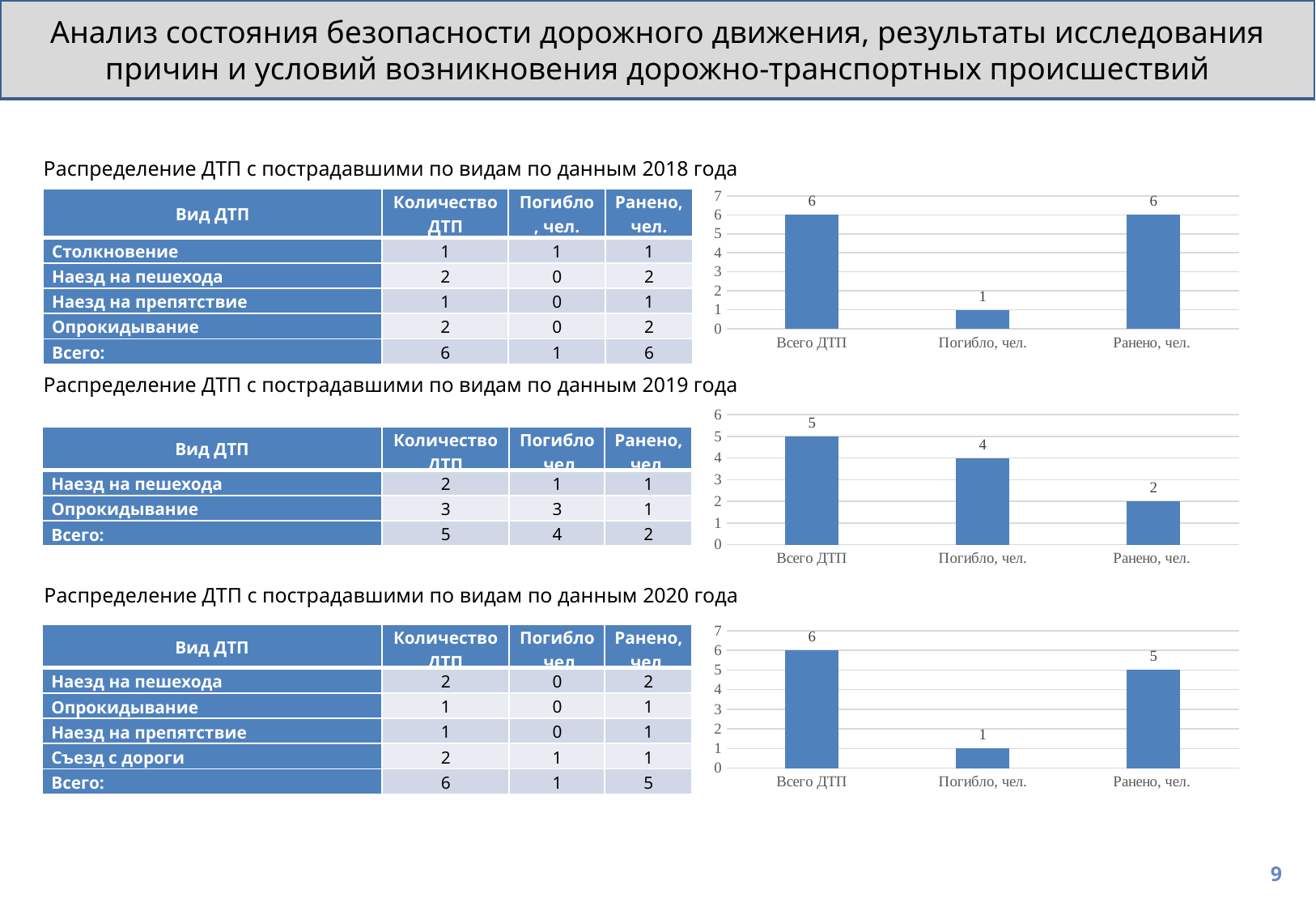
In the top chart (2018 data), what is the value for Всего ДТП? 6 In the bottom chart (2020 data), which category has the highest value? Всего ДТП In the top chart (2018 data), what is the value for Погибло, чел.? 1 In the middle chart (2019 data), what is the difference between Всего ДТП and Ранено, чел.? 3 What type of chart is the middle chart (2019 data)? Bar chart In the bottom chart (2020 data), what is the value for Ранено, чел.? 5 How many bar charts are on the slide? 3 In the bottom chart (2020 data), what is the difference between Всего ДТП and Погибло, чел.? 5 In the bottom chart (2020 data), which is larger, Погибло, чел. or Ранено, чел.? Ранено, чел. In the middle chart (2019 data), which category has the lowest value? Ранено, чел. In the middle chart (2019 data), what is the value for Погибло, чел.? 4 How many categories are shown on the x axis of the top chart (2018 data)? 3